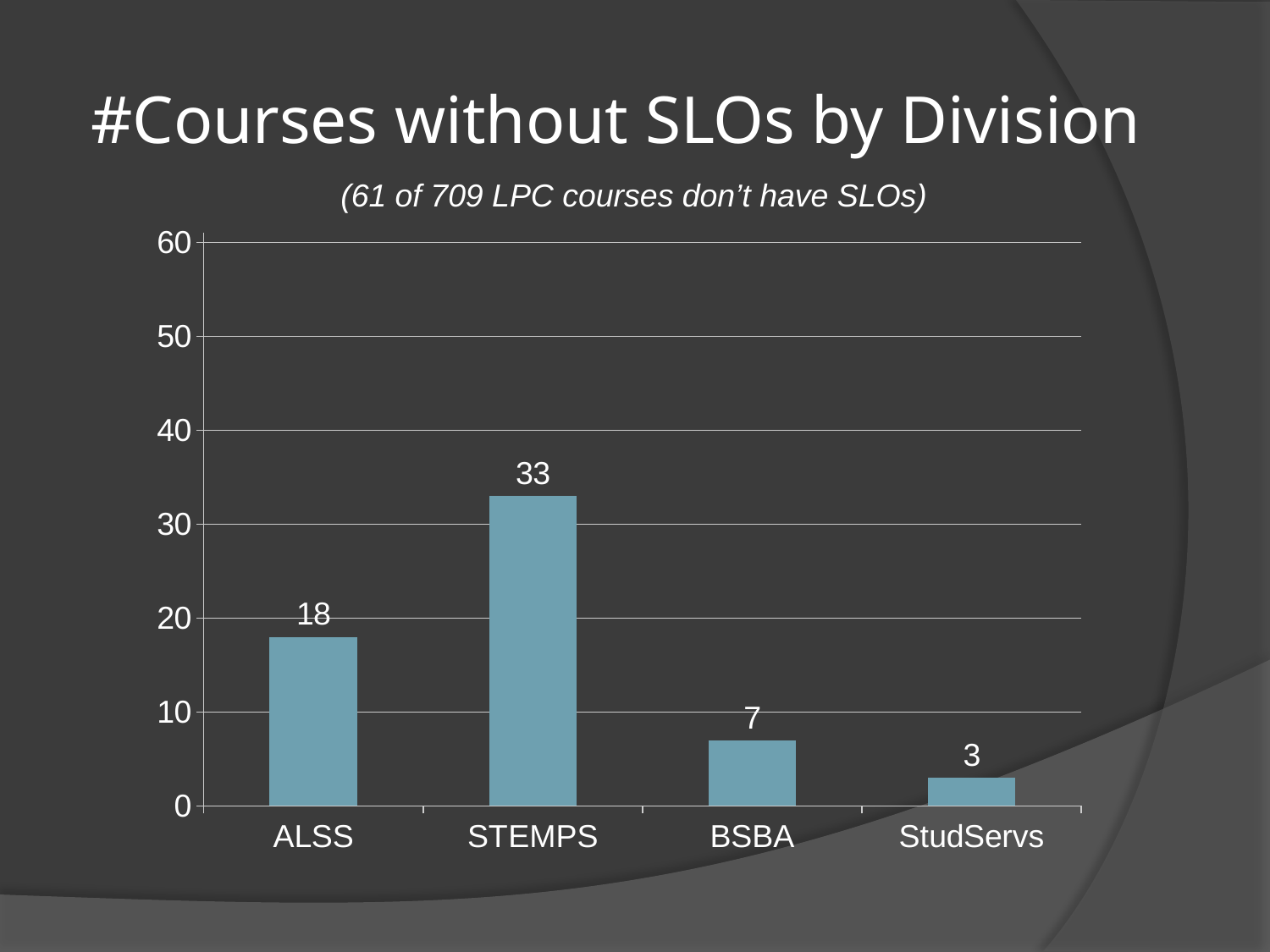
How many divisions are shown on the x axis? 4 What kind of chart is shown on the slide? Bar chart Which division has the lowest number of courses without SLOs? StudServs What is the value shown for StudServs? 3 What is the difference between the values for BSBA and StudServs? 4 What is the value shown for ALSS? 18 Which has a larger value, ALSS or BSBA? ALSS Which division has the highest number of courses without SLOs? STEMPS How many courses without SLOs does the STEMPS division have? 33 Is the value for STEMPS greater or less than 30? greater What is the title of the chart on the slide? #Courses without SLOs by Division What is the difference between the values for STEMPS and ALSS? 15